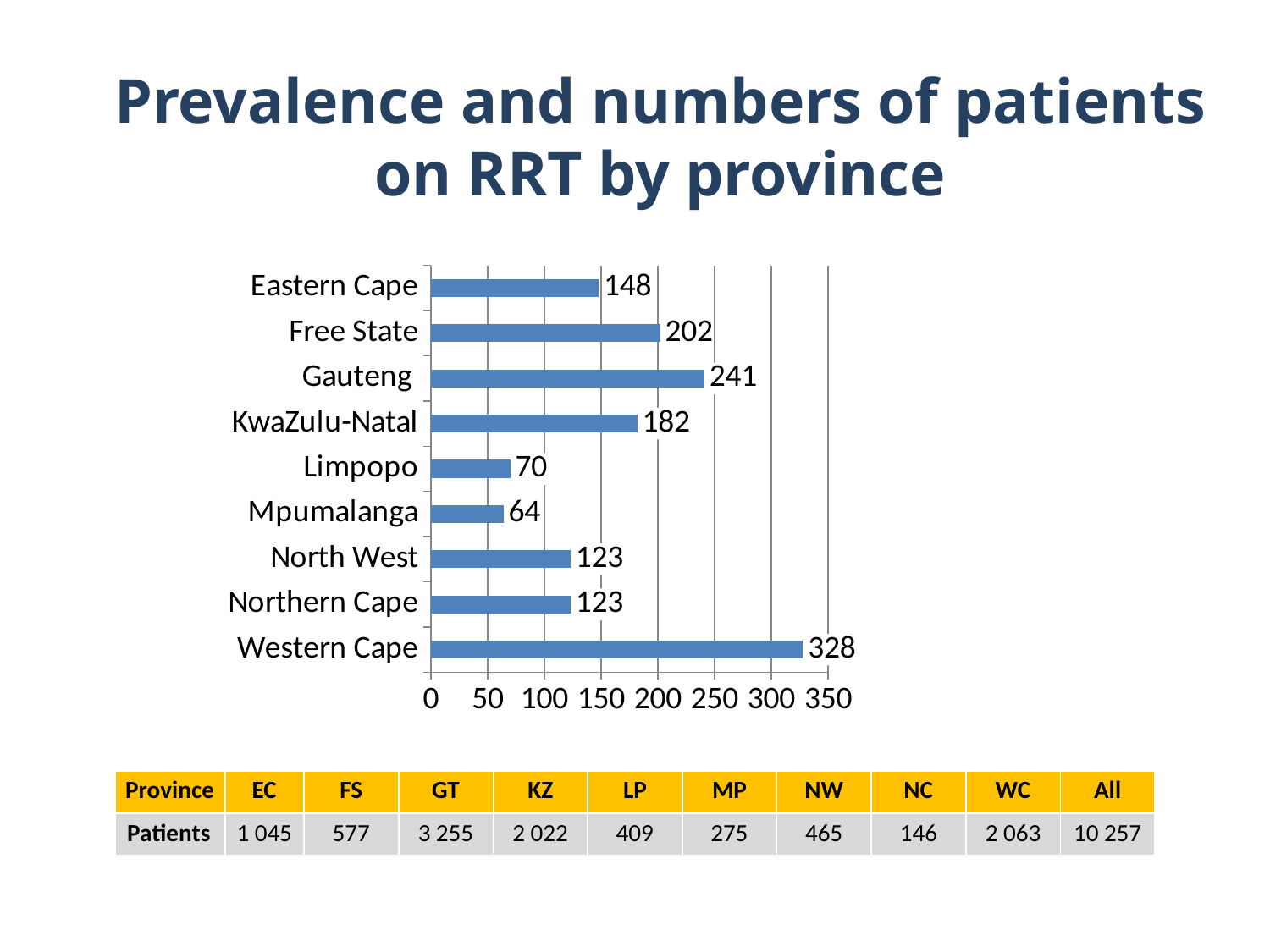
How many provinces are shown in the bar chart? 9 What is the value for Gauteng in the bar chart? 241 What kind of chart is shown on the slide? bar chart What is the value for Mpumalanga in the bar chart? 64 What is the difference between the values for Western Cape and Gauteng in the bar chart? 87 Which province has the lowest value in the bar chart? Mpumalanga Which has a larger value in the bar chart, KwaZulu-Natal or Free State? Free State What is the value for Western Cape in the bar chart? 328 What is the maximum value shown on the x axis of the bar chart? 350 Which province has the highest value in the bar chart? Western Cape Is the value for Limpopo in the bar chart greater or less than 100? less What is the difference between the values for Free State and Eastern Cape in the bar chart? 54